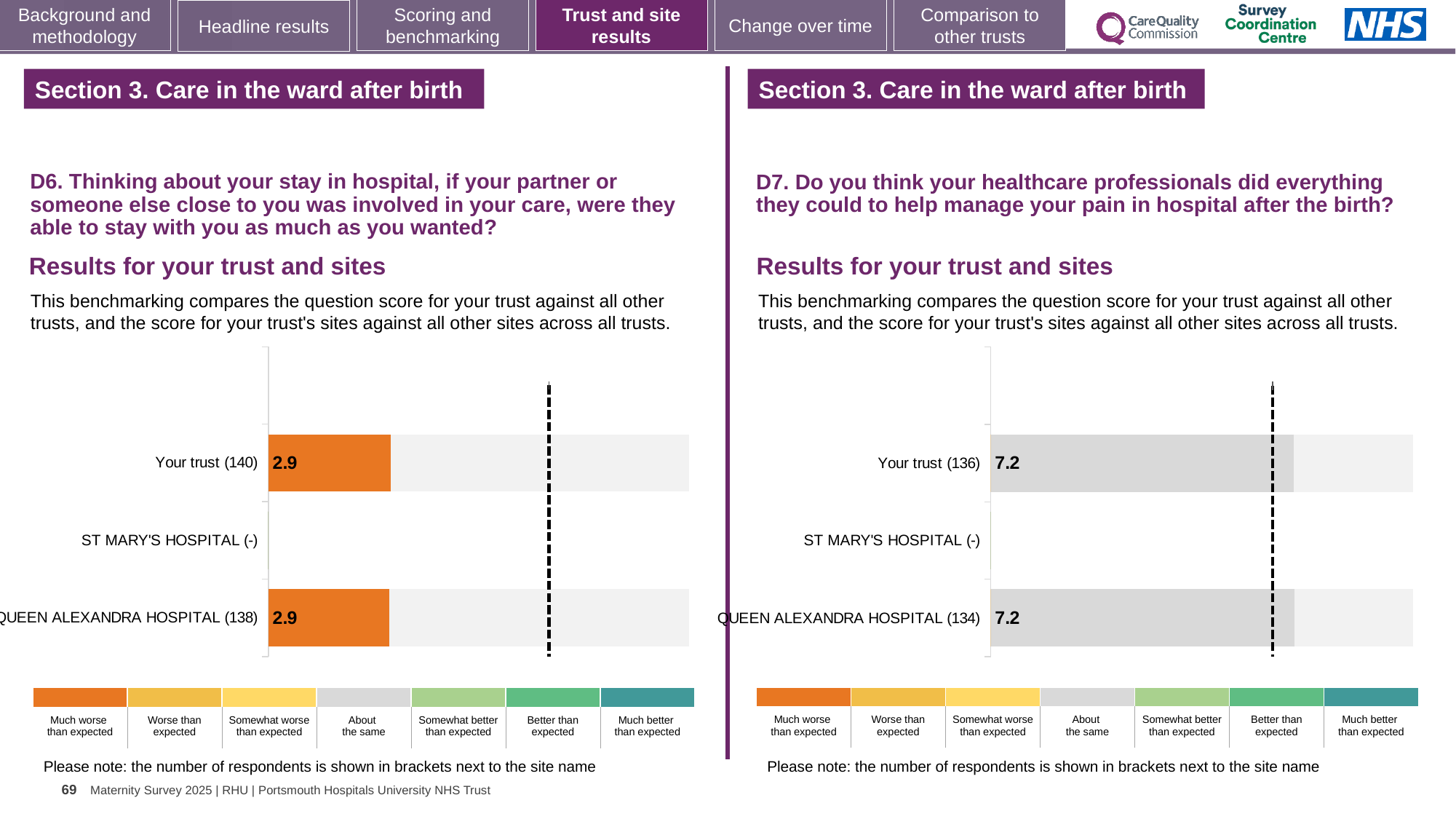
In the D6 chart on the left, which benchmark category does the orange colour of the bars correspond to in the legend? Much worse than expected In the D6 chart on the left, what is the difference between the score for Your trust and the score for QUEEN ALEXANDRA HOSPITAL? 0 In the D6 chart on the left, what is the score for Your trust (140)? 2.9 How many categories (rows) are listed on the y axis of the D6 chart on the left? 3 In the D7 chart on the right, what is the score for QUEEN ALEXANDRA HOSPITAL (134)? 7.2 How many benchmark categories does the colour legend below the D6 chart on the left list? 7 What kind of chart is used for the D7 results on the right? Bar chart In the D7 chart on the right, what is the score for Your trust (136)? 7.2 How many respondents are shown in brackets for QUEEN ALEXANDRA HOSPITAL in the D6 chart on the left? 138 In the D6 chart on the left, what is the score for QUEEN ALEXANDRA HOSPITAL (138)? 2.9 In the D7 chart on the right, which site has no score shown? ST MARY'S HOSPITAL (-) How many respondents are shown in brackets for Your trust in the D7 chart on the right? 136